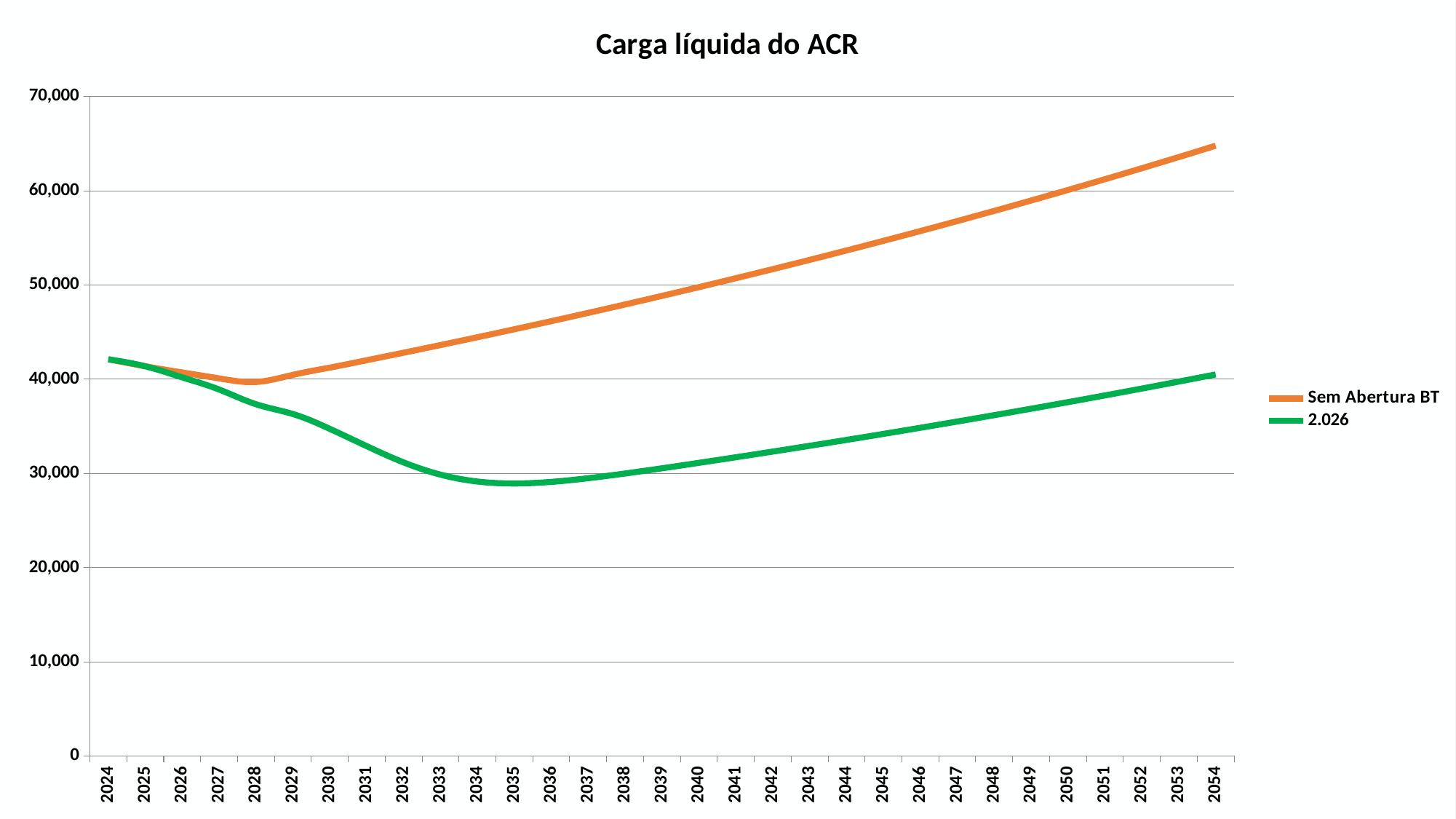
How many years are shown on the x axis? 31 Is the value for 2.026 in 2054 greater or less than 30,000? greater Is the value for 2.026 in 2035 greater or less than 40,000? less In which year does the 2.026 series reach its lowest value? 2035 Is the value for Sem Abertura BT in 2054 greater or less than 60,000? greater Does the Sem Abertura BT series rise or fall from 2028 to 2054? rise How many series does the legend list? 2 Which series is drawn in green? 2.026 In 2040, which series has the higher value, Sem Abertura BT or 2.026? Sem Abertura BT What is the title of the chart? Carga líquida do ACR What kind of chart is shown on the slide? line chart